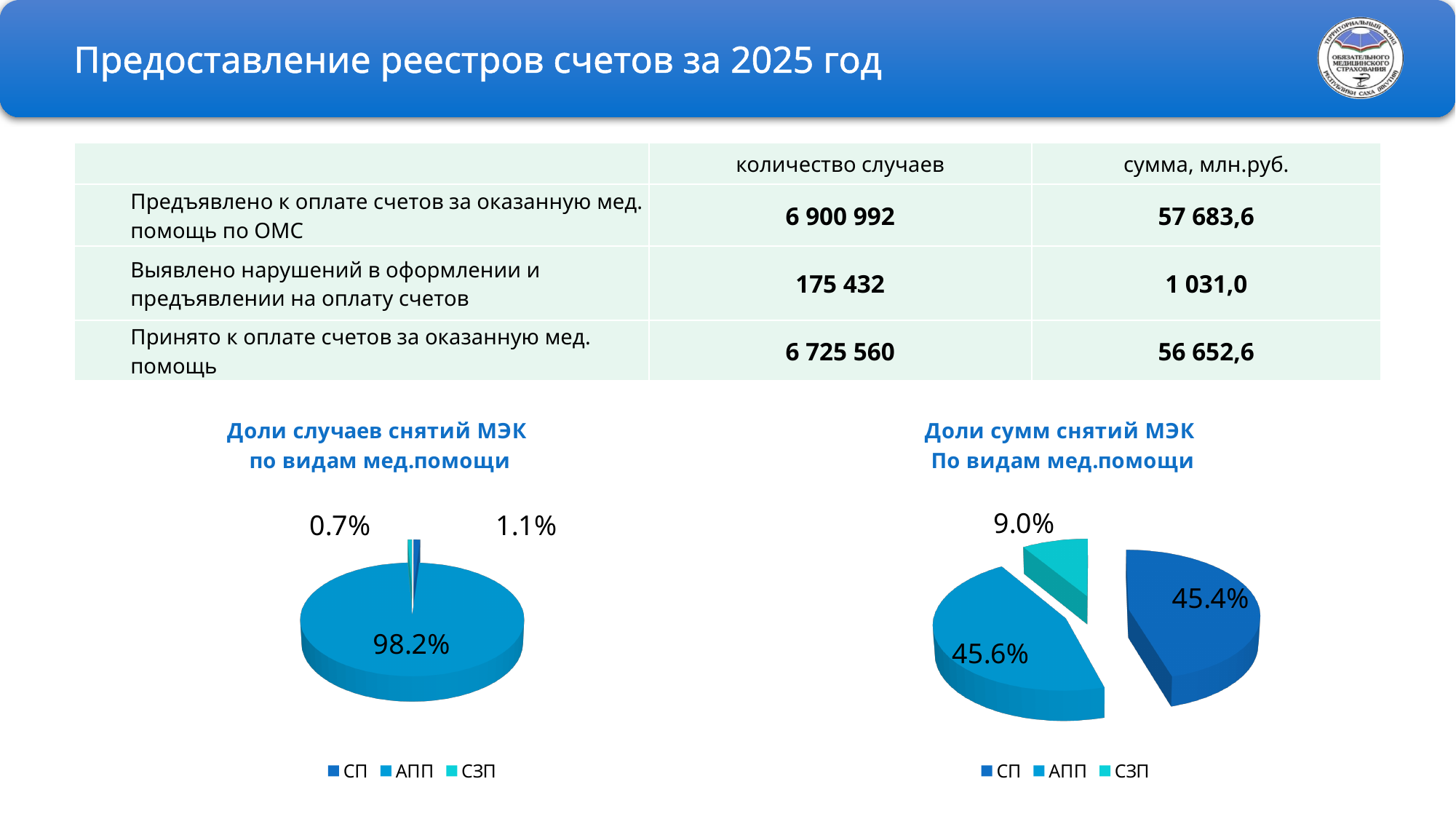
How many entries does the legend of the chart "Доли сумм снятий МЭК По видам мед.помощи" list? 3 What are the legend entries of the chart "Доли случаев снятий МЭК по видам мед.помощи"? СП, АПП, СЗП In the chart "Доли сумм снятий МЭК По видам мед.помощи", what is the difference between the shares for АПП and СП? 0.2 percentage points How many slices does the chart "Доли случаев снятий МЭК по видам мед.помощи" have? 3 In the chart "Доли случаев снятий МЭК по видам мед.помощи", which category has the largest share? АПП In the chart "Доли сумм снятий МЭК По видам мед.помощи", which category has the smallest share? СЗП In the chart "Доли сумм снятий МЭК По видам мед.помощи", what is the share for СЗП? 9.0% In the chart "Доли случаев снятий МЭК по видам мед.помощи", what is the share for АПП? 98.2% What kind of chart is the chart titled "Доли сумм снятий МЭК По видам мед.помощи"? pie chart In the chart "Доли сумм снятий МЭК По видам мед.помощи", what is the share for АПП? 45.6% In the chart "Доли сумм снятий МЭК По видам мед.помощи", what is the share for СП? 45.4% In the chart "Доли сумм снятий МЭК По видам мед.помощи", which is larger, the share for СП or the share for СЗП? СП